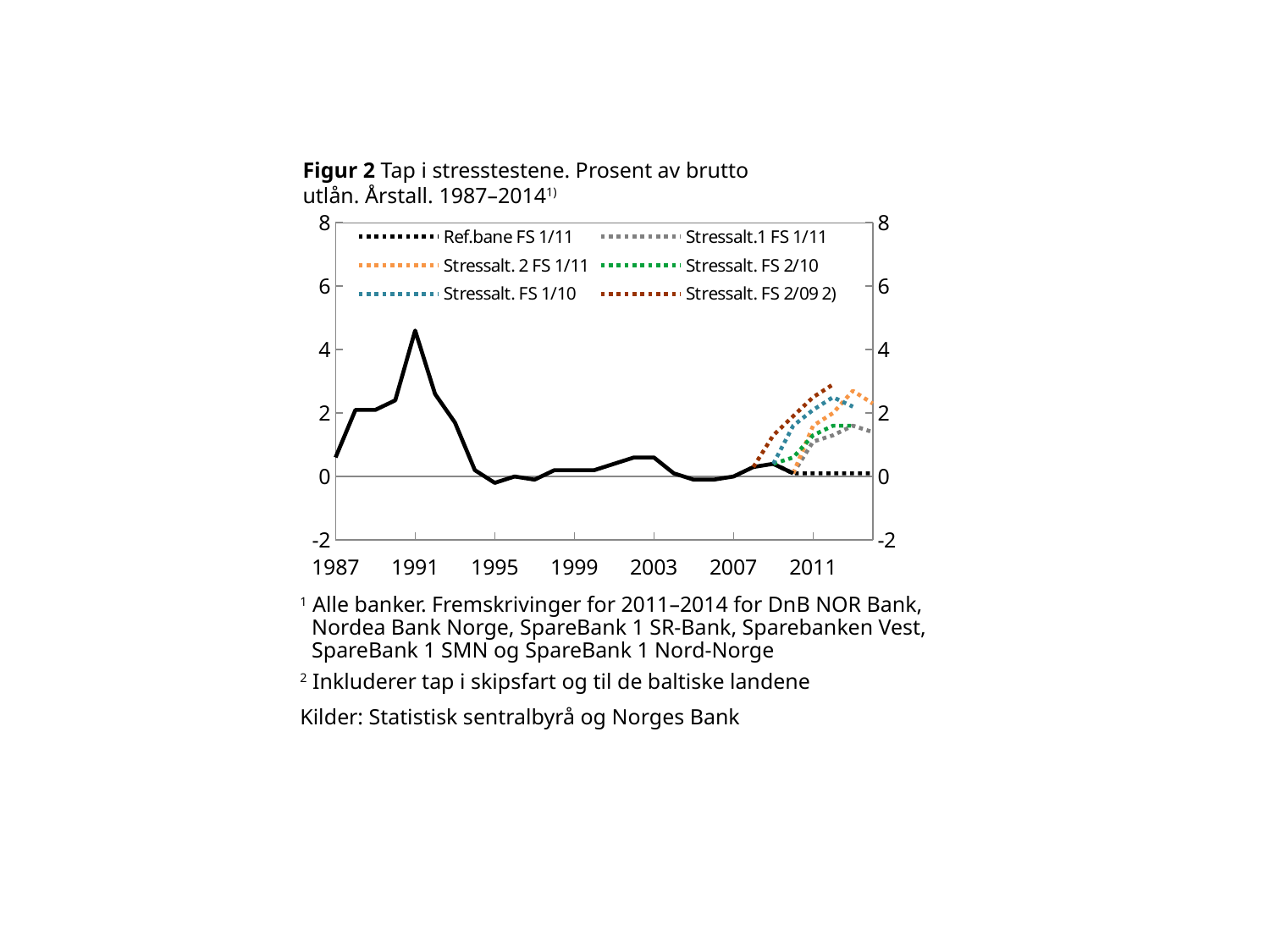
What is the title of the chart? Figur 2 Tap i stresstestene. Prosent av brutto utlån. Årstall. 1987–2014 Is the value of the solid historical line in 1991 greater or less than 4? greater Is the value of Ref.bane FS 1/11 in 2014 greater or less than 2? less Does the solid historical line rise or fall between 1991 and 1995? fall Is the value of the solid historical line in 1995 greater or less than 2? less What kind of chart is shown on the slide? line chart In which year does the solid historical line reach its highest value? 1991 Which legend entry is drawn in black? Ref.bane FS 1/11 Does the solid historical line rise or fall between 1987 and 1991? rise Which is higher in 2012: Stressalt. FS 2/09 2) or Ref.bane FS 1/11? Stressalt. FS 2/09 2) What is the first year shown on the x axis? 1987 How many series does the legend list? 6